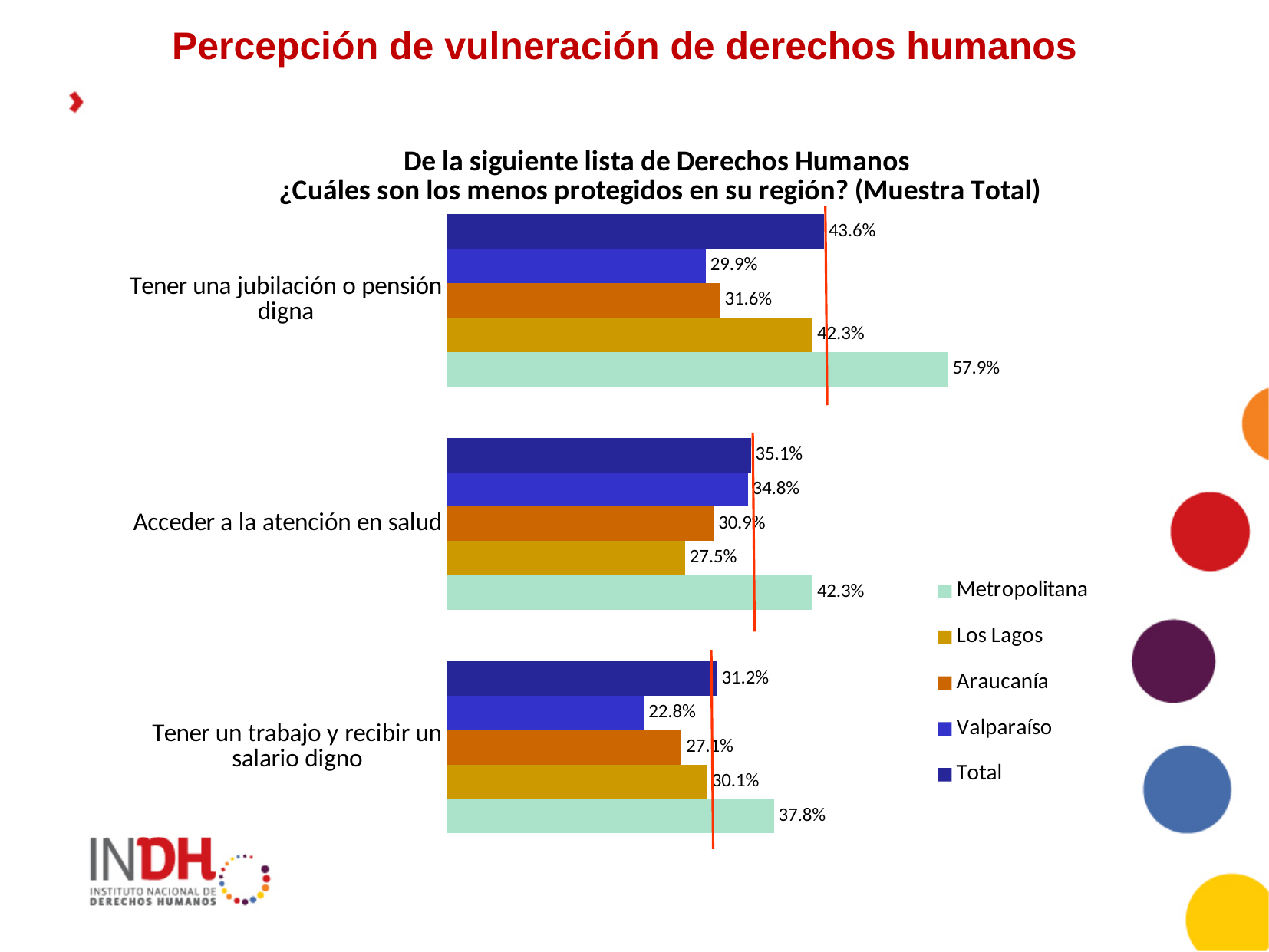
Which region has the highest value for 'Tener una jubilación o pensión digna'? Metropolitana For 'Acceder a la atención en salud', which is larger: the Araucanía value or the Los Lagos value? Araucanía What is the Metropolitana value for 'Tener una jubilación o pensión digna'? 57.9% Which region has the lowest value for 'Tener un trabajo y recibir un salario digno'? Valparaíso What is the Los Lagos value for 'Acceder a la atención en salud'? 27.5% What is the Valparaíso value for 'Tener un trabajo y recibir un salario digno'? 22.8% How many categories (rights) are shown on the chart? 3 What is the Total value for 'Acceder a la atención en salud'? 35.1% How many series does the legend list? 5 Which series is shown in light green in the legend? Metropolitana What is the difference between the Metropolitana and Total values for 'Tener una jubilación o pensión digna'? 14.3% What kind of chart is shown on the slide? Bar chart